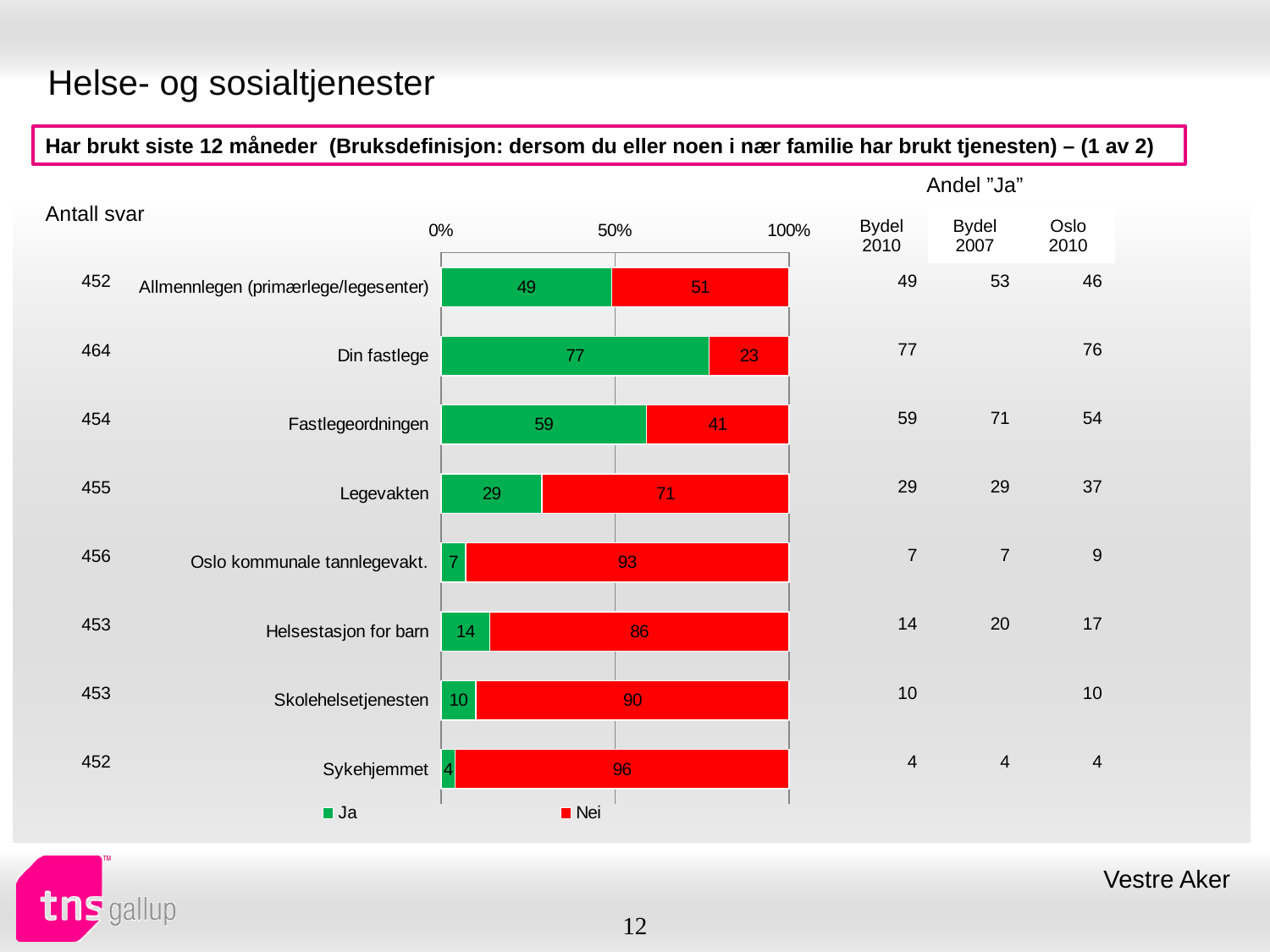
What is the difference between the "Ja" values for Din fastlege and Fastlegeordningen? 18 How many categories are shown in the bar chart? 8 What is the "Ja" value for Din fastlege? 77 Which category has the highest "Ja" value? Din fastlege What is the total of the stacked bar for Allmennlegen (primærlege/legesenter)? 100 Which colour represents the "Nei" series? Red Which has a larger "Nei" value, Skolehelsetjenesten or Oslo kommunale tannlegevakt.? Oslo kommunale tannlegevakt. What kind of chart is shown on the slide? Stacked bar chart How many series does the legend list? 2 What is the "Nei" value for Legevakten? 71 What is the "Ja" value for Helsestasjon for barn? 14 Which category has the lowest "Ja" value? Sykehjemmet